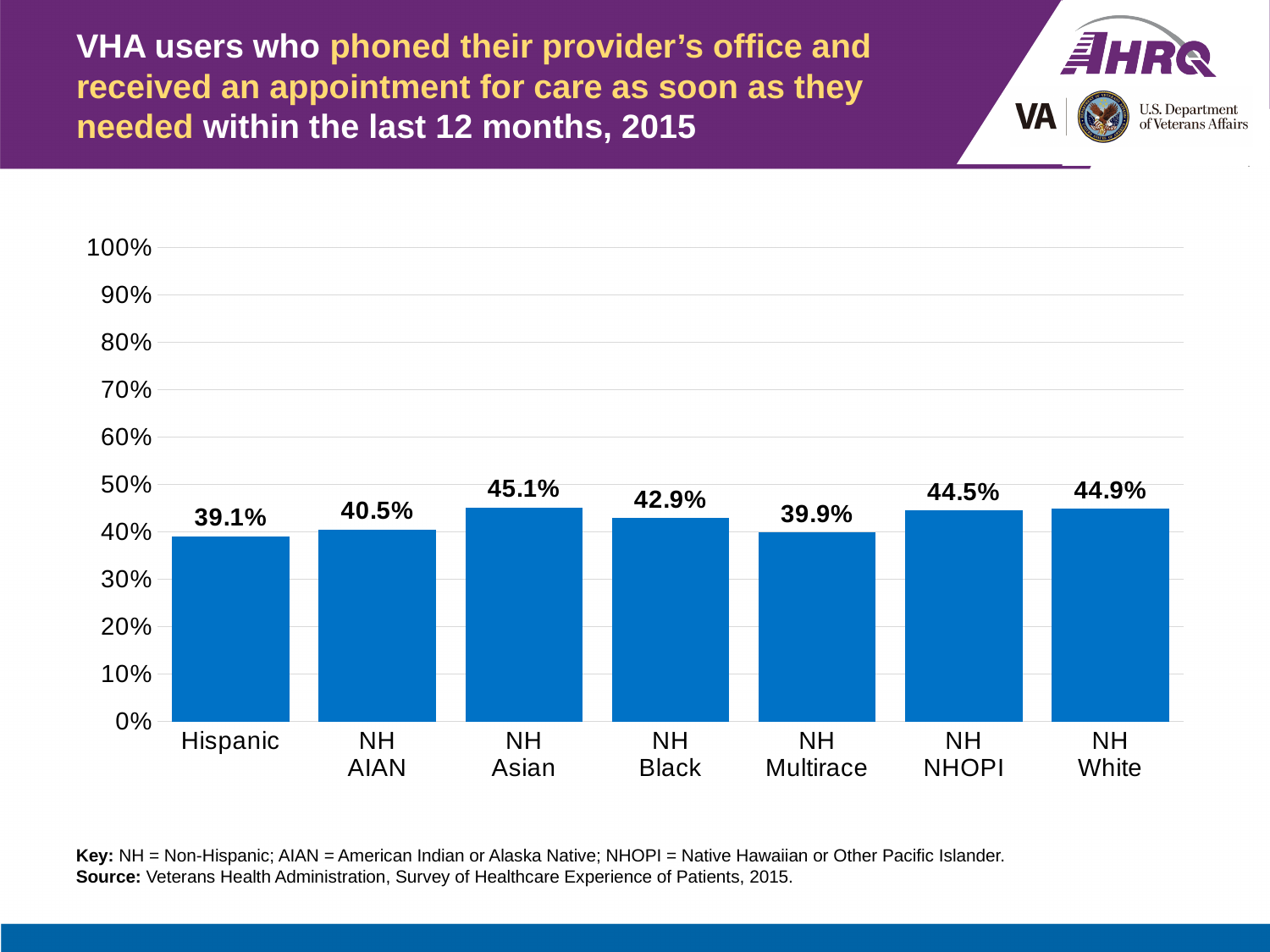
What is the value for NH Multirace? 39.9% What kind of chart is shown on the slide? Bar chart What is the difference between the values for NH White and NH Black? 2.0% What is the value for NH NHOPI? 44.5% Which category has the lowest value? Hispanic What is the value for NH Asian? 45.1% What is the value for Hispanic? 39.1% How many categories are shown on the x axis? 7 Is the value for NH White greater or less than 40%? greater According to the key, what does NHOPI stand for? Native Hawaiian or Other Pacific Islander Which category has the highest value? NH Asian Which is larger, the value for NH AIAN or the value for NH Black? NH Black